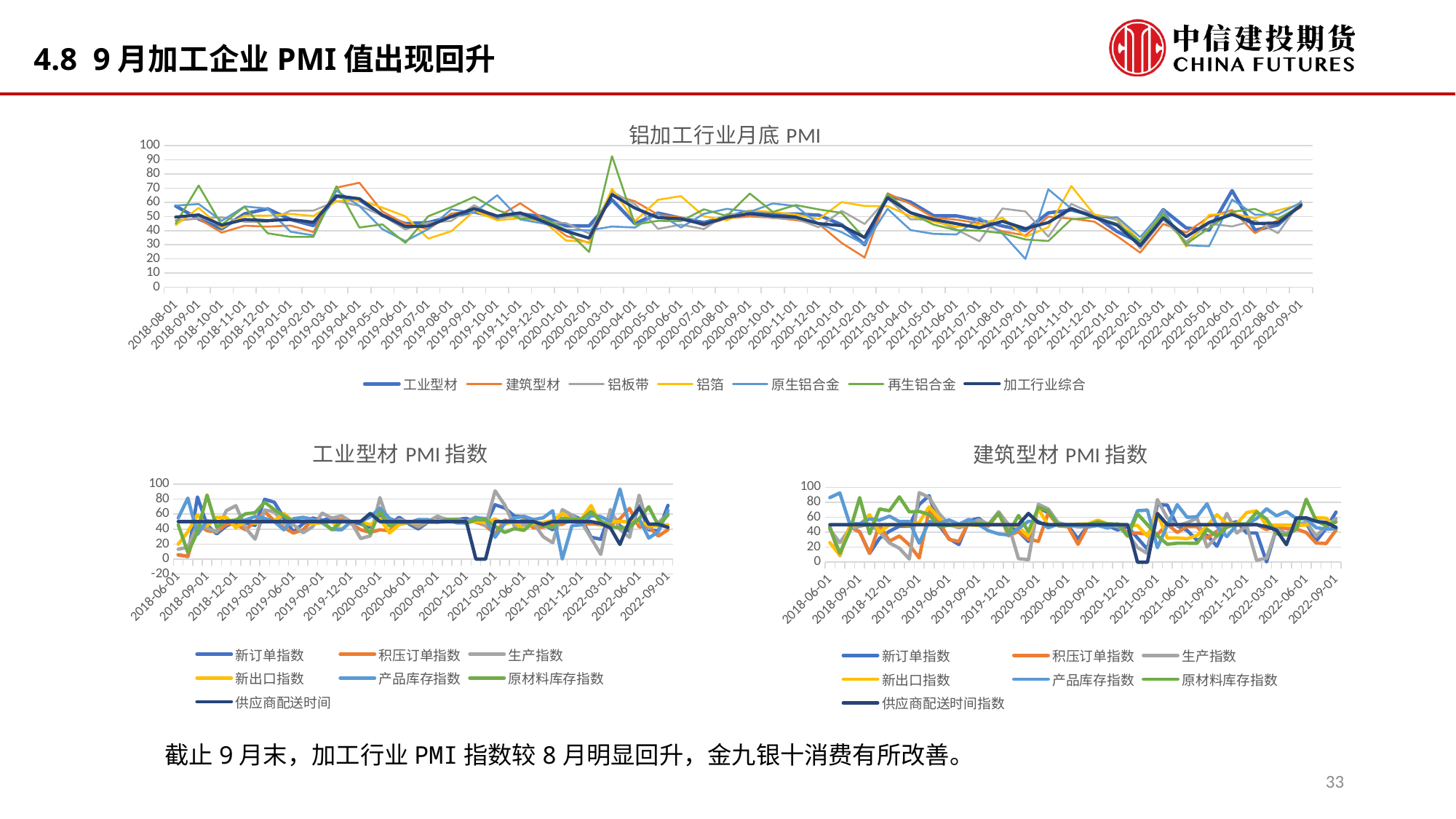
How many series does the legend of the 建筑型材 PMI 指数 chart list? 7 How many series does the legend of the 铝加工行业月底 PMI chart list? 7 In the 铝加工行业月底 PMI chart, does the 加工行业综合 line rise or fall from 2022-08-01 to 2022-09-01? rise In the 铝加工行业月底 PMI chart, is the value for 建筑型材 at 2021-02-01 greater or less than 30? less In the 铝加工行业月底 PMI chart, is the value for 原生铝合金 at 2021-09-01 greater or less than 30? less What is the lowest value shown on the y axis of the 工业型材 PMI 指数 chart? -20 In the 铝加工行业月底 PMI chart, which series reaches the highest peak, around 2020-03-01? 再生铝合金 What kind of chart is the 建筑型材 PMI 指数 chart? line chart In the 铝加工行业月底 PMI chart, is the peak value of 再生铝合金 around 2020-03-01 greater or less than 80? greater What is the first date label on the x axis of the 铝加工行业月底 PMI chart? 2018-08-01 How many series does the legend of the 工业型材 PMI 指数 chart list? 7 What kind of chart is the 铝加工行业月底 PMI chart? line chart